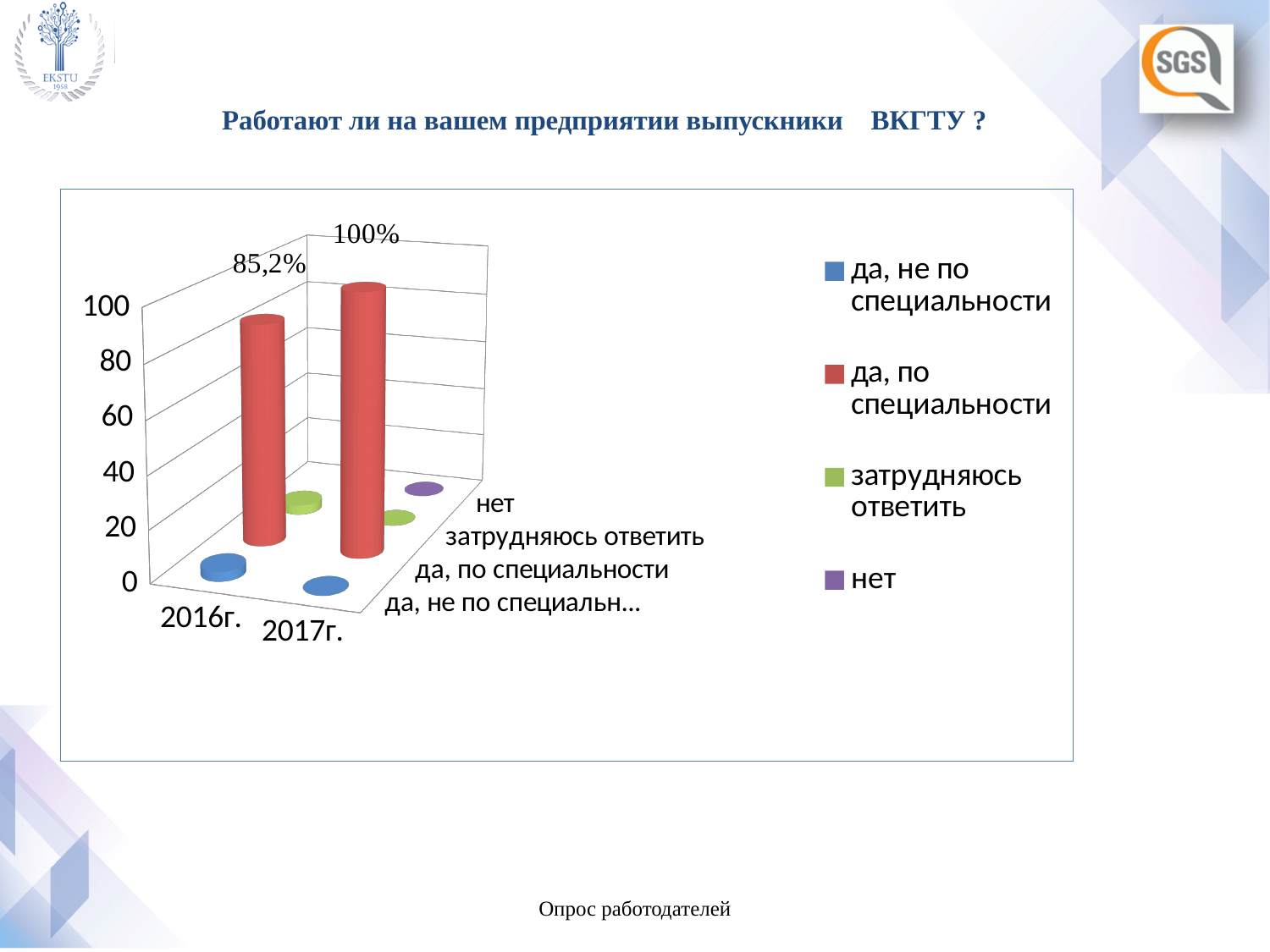
What kind of chart is shown on the slide? bar chart How many years are shown on the x axis of the chart? 2 Which year has the larger value for "да, по специальности", 2016г. or 2017г.? 2017г. What is the value for "да, по специальности" in 2017г.? 100% What is the value for "да, по специальности" in 2016г.? 85,2% Is the value for "нет" in 2017г. greater or less than 20? less Does the value for "да, по специальности" rise or fall from 2016г. to 2017г.? rise What colour represents "нет" in the legend? purple Which response category has the highest value in 2016г.? да, по специальности What is the difference between the "да, по специальности" values for 2017г. and 2016г.? 14,8% How many series does the legend list? 4 Is the value for "да, по специальности" in 2016г. greater or less than 80? greater